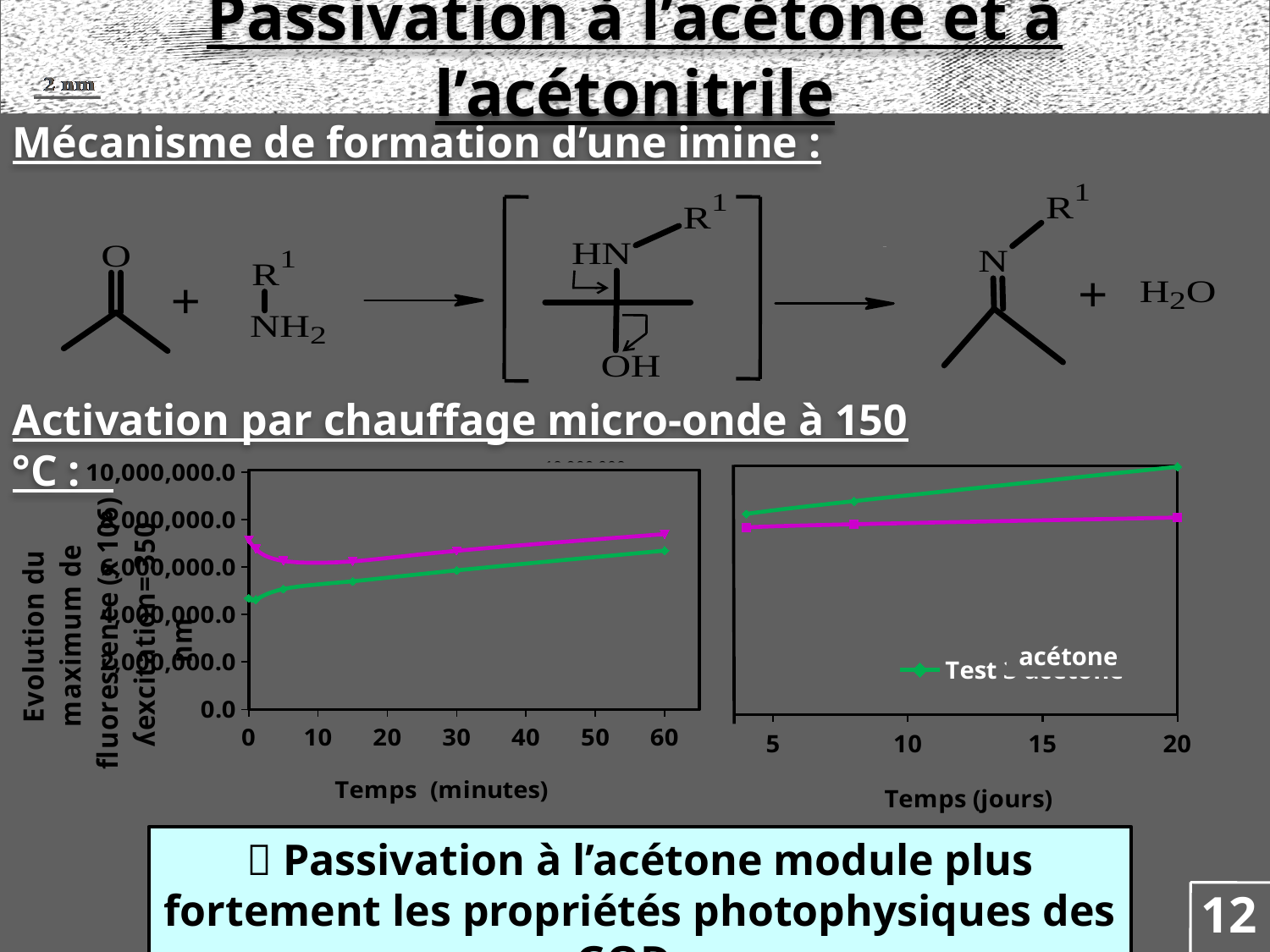
In the left chart (Temps (minutes)), does the green series rise or fall from 0 to 60 minutes? rise In the left chart (Temps (minutes)), is the value of the magenta series at 60 minutes greater or less than 6,000,000.0? greater In the left chart (Temps (minutes)), how many data points does the green series have? 6 In the left chart (Temps (minutes)), at 0 minutes, which series has the larger value, the magenta or the green one? magenta What is the x-axis title of the left chart? Temps (minutes) What is the x-axis title of the right chart? Temps (jours) What kind of chart is the left chart (Temps (minutes))? line chart In the left chart (Temps (minutes)), is the value of the magenta series at 60 minutes greater or less than 4,000,000.0? greater In the right chart (Temps (jours)), at 20 days, which series has the larger value, the green or the magenta one? green What kind of chart is the right chart (Temps (jours))? line chart In the left chart (Temps (minutes)), is the value of the green series at 0 minutes greater or less than 4,000,000.0? greater In the right chart (Temps (jours)), does the green series rise or fall from 5 to 20 days? rise